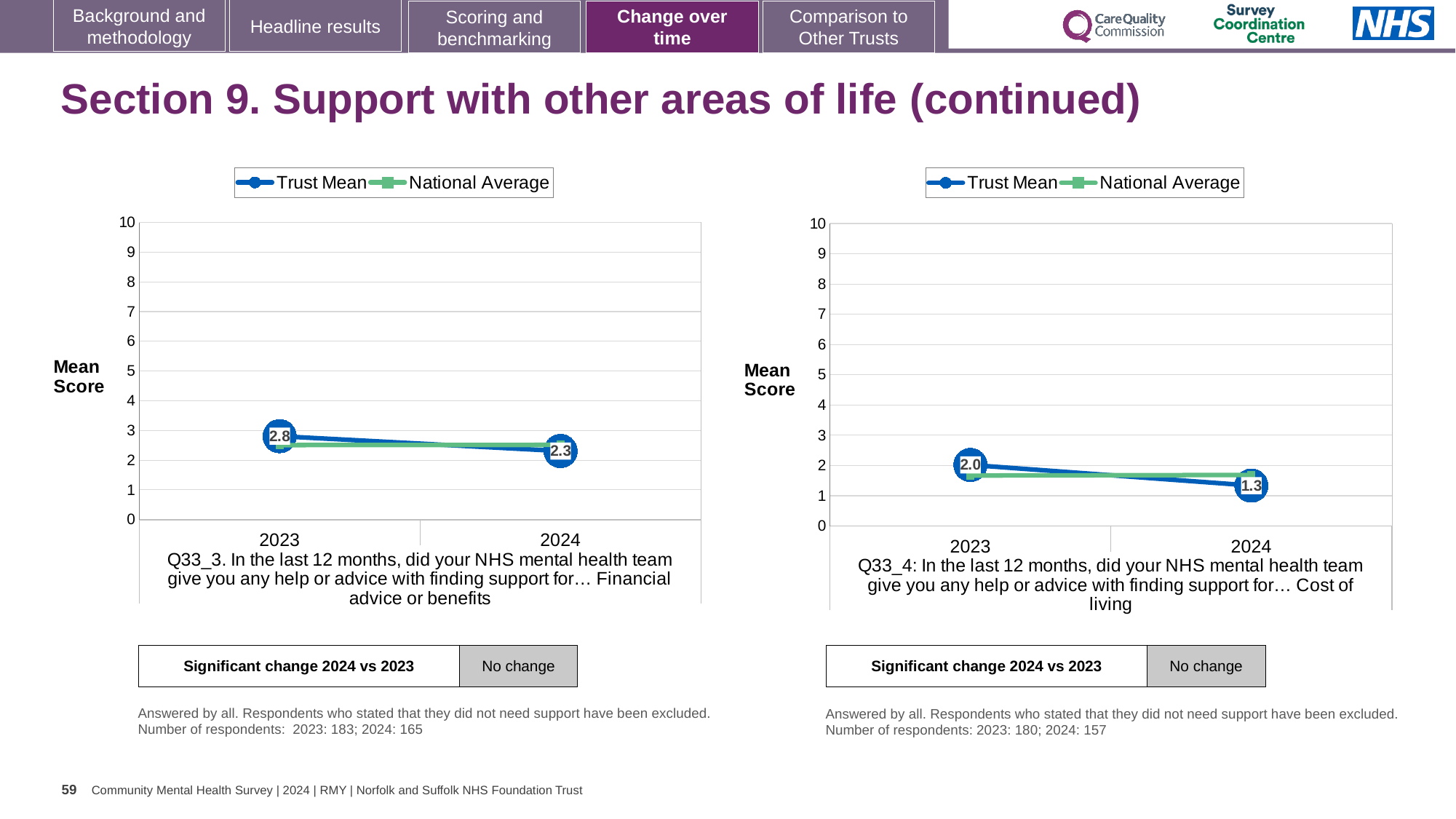
In the right chart (Q33_4, Cost of living), what is the Trust Mean for 2023? 2.0 In the right chart (Q33_4), which year has the higher Trust Mean, 2023 or 2024? 2023 In the left chart (Q33_3), is the National Average value for 2023 greater or less than 3? less In the left chart (Q33_3), by how much did the Trust Mean fall from 2023 to 2024? 0.5 In the left chart (Q33_3, Financial advice or benefits), what is the Trust Mean for 2023? 2.8 In the left chart (Q33_3, Financial advice or benefits), what is the Trust Mean for 2024? 2.3 In the right chart (Q33_4, Cost of living), what is the Trust Mean for 2024? 1.3 How many series does the legend of the right chart (Q33_4) list? 2 How many years are plotted on the x axis of the right chart (Q33_4)? 2 What kind of chart is the left chart (Q33_3)? line chart In the left chart (Q33_3), does the Trust Mean rise or fall from 2023 to 2024? fall In the right chart (Q33_4), what is the difference between the Trust Mean in 2023 and in 2024? 0.7